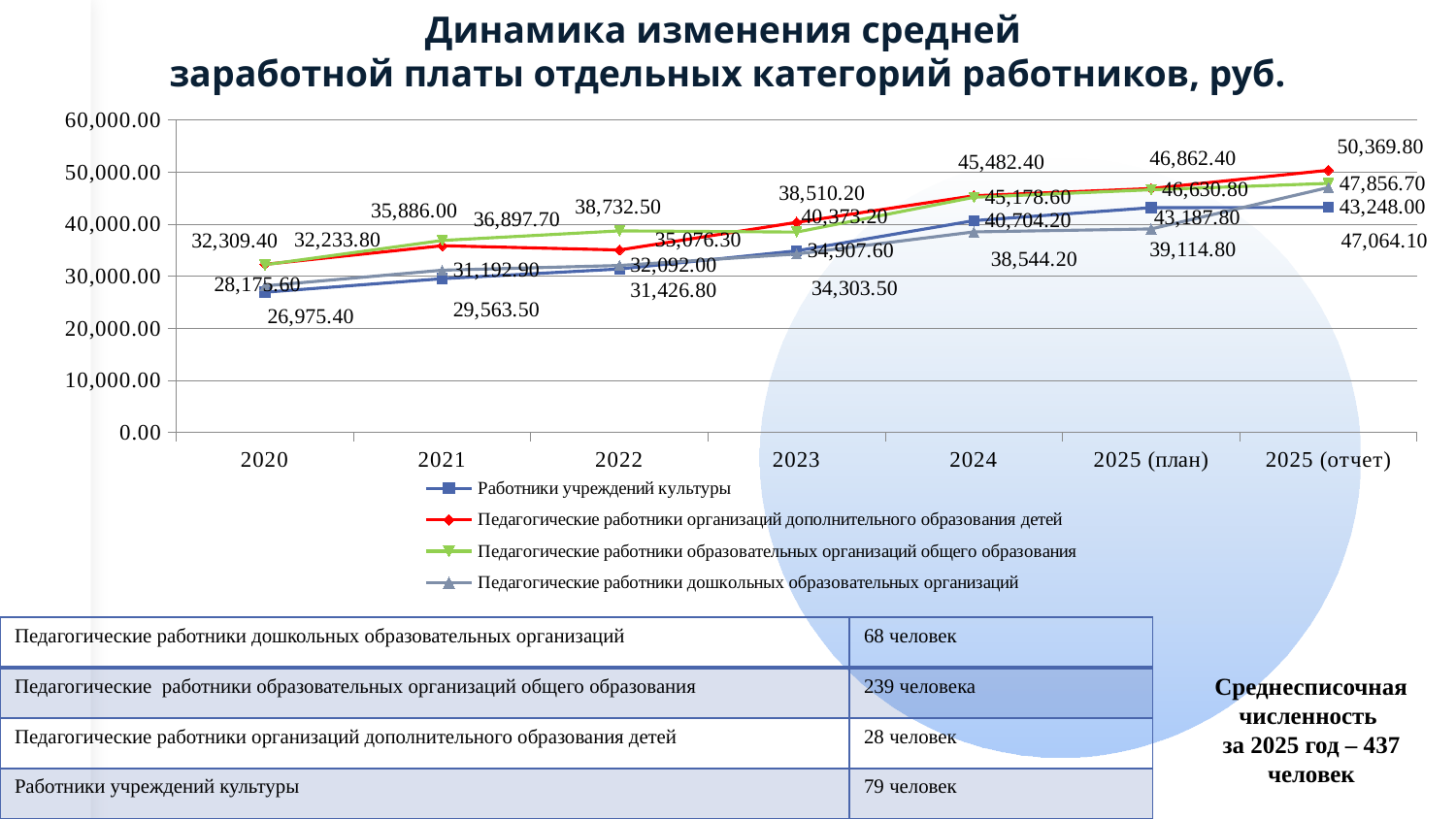
What is the value for Работники учреждений культуры in 2025 (отчет)? 43,248.00 Is the value for Педагогические работники дошкольных образовательных организаций in 2024 greater or less than 40,000.00? less How many points are plotted along the x axis? 7 How many series does the legend list? 4 What kind of chart is shown on the slide? line chart Which series has the highest value in 2025 (отчет)? Педагогические работники организаций дополнительного образования детей What is the value for Педагогические работники организаций дополнительного образования детей in 2025 (отчет)? 50,369.80 What is the difference between the 2025 (отчет) and 2025 (план) values for Педагогические работники организаций дополнительного образования детей? 3,507.40 What is the value for Педагогические работники дошкольных образовательных организаций in 2025 (план)? 39,114.80 What is the value for Педагогические работники образовательных организаций общего образования in 2022? 38,732.50 What is the lowest value labelled on the chart? 26,975.40 Does the line for Педагогические работники организаций дополнительного образования детей rise or fall overall from 2020 to 2025 (отчет)? rise